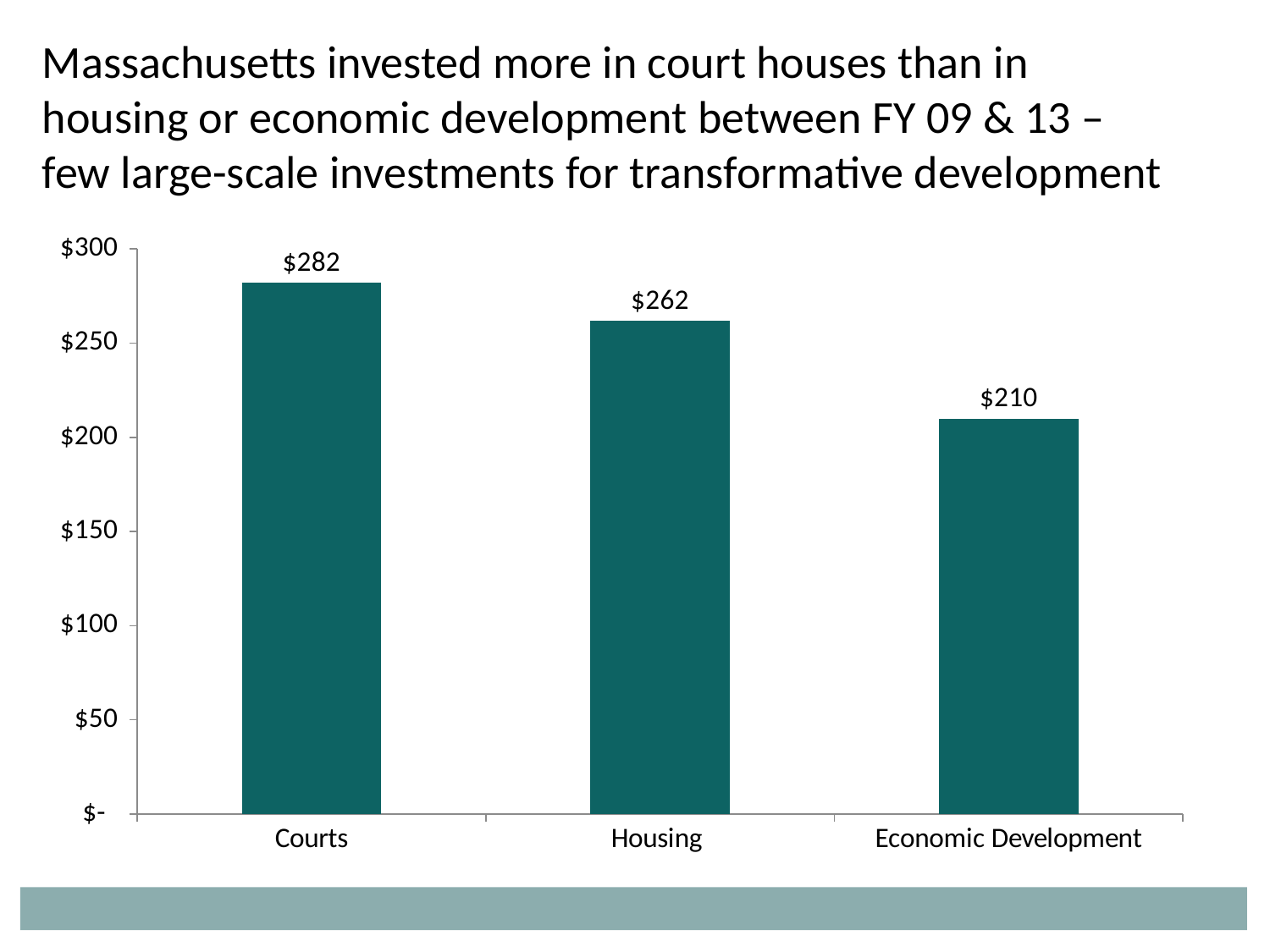
What is the value for Economic Development? $210 What is the difference between the values for Housing and Economic Development? $52 Which category has the lowest value? Economic Development Do the values rise or fall from left to right along the x axis? fall Is the value for Housing greater or less than $250? greater How many categories are shown on the x axis? 3 What kind of chart is shown on the slide? bar chart What is the difference between the values for Courts and Housing? $20 Which category has the highest value? Courts Which is larger, the value for Courts or the value for Economic Development? Courts What is the value for Housing? $262 What is the value for Courts? $282